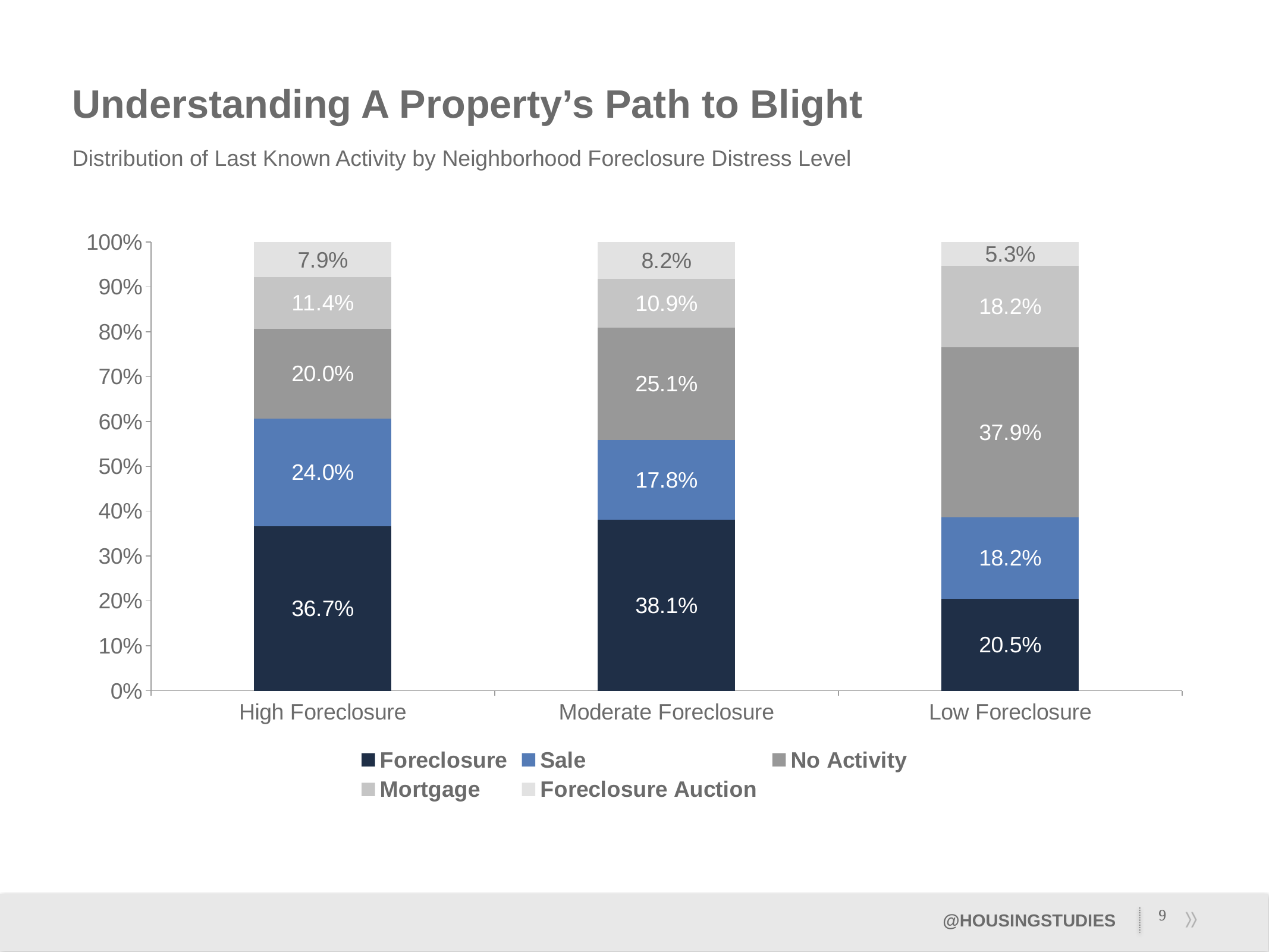
How many neighborhood distress levels are shown on the x axis? 3 How many series does the legend list? 5 Which neighborhood distress level has the highest Foreclosure share? Moderate Foreclosure Which series is shown in the darkest colour at the bottom of each bar? Foreclosure What is the Foreclosure Auction share for Low Foreclosure neighborhoods? 5.3% What kind of chart is shown on the slide? Stacked bar chart What is the Foreclosure share for High Foreclosure neighborhoods? 36.7% What is the Sale share for Moderate Foreclosure neighborhoods? 17.8% Which neighborhood distress level has the lowest Sale share? Moderate Foreclosure What is the difference between the No Activity share in Low Foreclosure and High Foreclosure neighborhoods? 17.9% What is the No Activity share for Low Foreclosure neighborhoods? 37.9% Which is larger: the Mortgage share in High Foreclosure or in Moderate Foreclosure neighborhoods? High Foreclosure